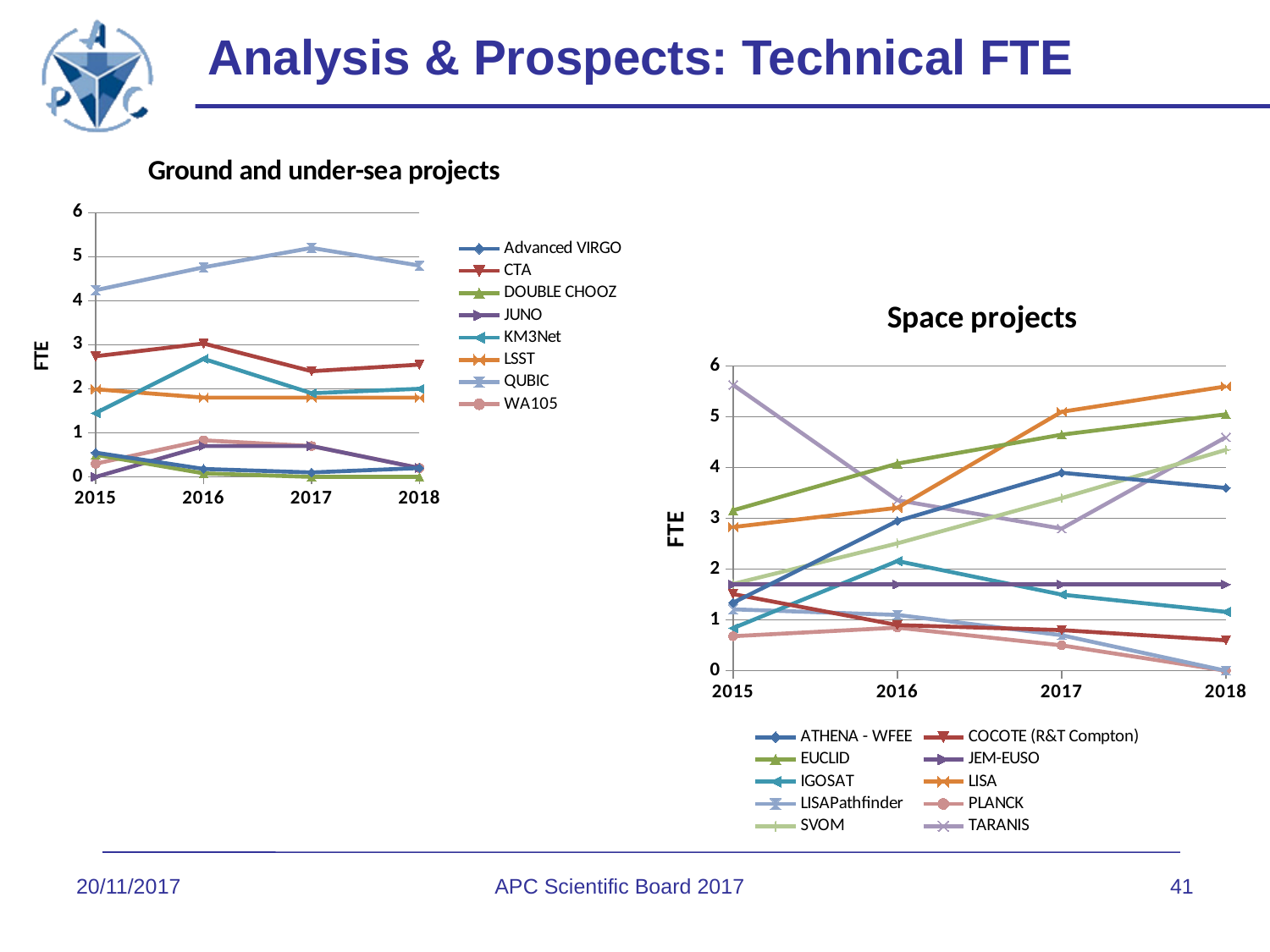
How many series does the legend of the "Space projects" chart list? 10 What is the label of the y axis on the "Space projects" chart? FTE In the "Ground and under-sea projects" chart, is the value for KM3Net in 2016 greater or less than 2? greater In the "Space projects" chart, which project has the highest FTE in 2018? LISA What type of chart is the "Ground and under-sea projects" chart? line chart In the "Space projects" chart, is the value for ATHENA - WFEE in 2017 greater or less than 4? less In the "Ground and under-sea projects" chart, which project has the highest FTE in 2017? QUBIC How many series does the legend of the "Ground and under-sea projects" chart list? 8 How many years are shown on the x axis of the "Space projects" chart? 4 In the "Space projects" chart, does the FTE for EUCLID rise or fall from 2015 to 2018? rise In the "Space projects" chart, which project has the highest FTE in 2015? TARANIS